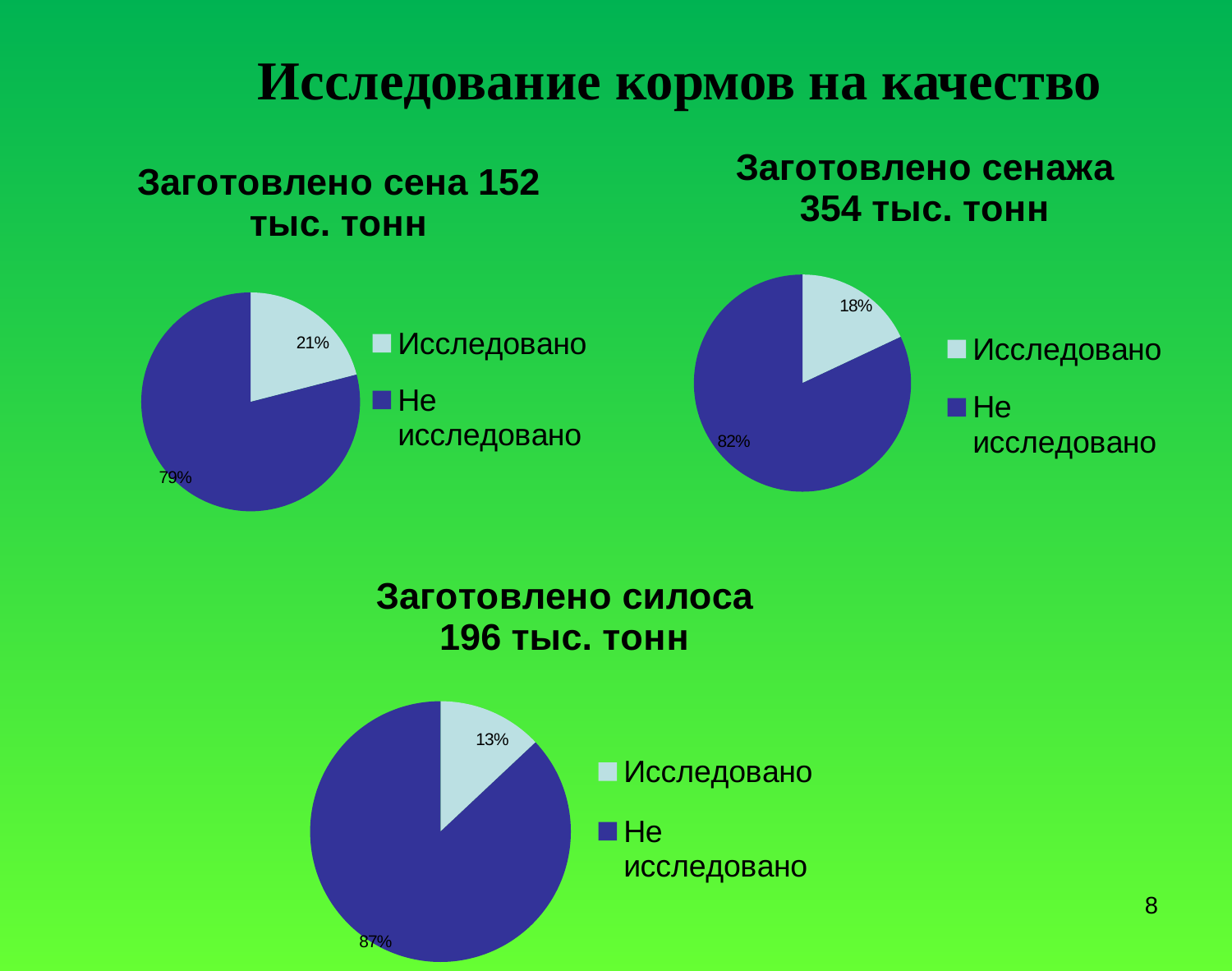
In the chart titled "Заготовлено сенажа 354 тыс. тонн", what share of the pie is "Исследовано"? 18% In the chart titled "Заготовлено сена 152 тыс. тонн", what share of the pie is "Исследовано"? 21% How many slices does the chart titled "Заготовлено сена 152 тыс. тонн" have? 2 What kind of chart is the chart titled "Заготовлено силоса 196 тыс. тонн"? Pie chart In the chart titled "Заготовлено сена 152 тыс. тонн", what is the value for "Не исследовано"? 79% In the chart titled "Заготовлено сенажа 354 тыс. тонн", what is the value for "Не исследовано"? 82% In the chart titled "Заготовлено силоса 196 тыс. тонн", what is the difference between "Не исследовано" and "Исследовано"? 74% How many entries does the legend of the chart titled "Заготовлено сенажа 354 тыс. тонн" list? 2 In the chart titled "Заготовлено сенажа 354 тыс. тонн", which slice is the smallest? Исследовано In the chart titled "Заготовлено силоса 196 тыс. тонн", what share of the pie is "Исследовано"? 13% In the chart titled "Заготовлено силоса 196 тыс. тонн", what is the value for "Не исследовано"? 87% In the chart titled "Заготовлено сена 152 тыс. тонн", which slice is the largest? Не исследовано